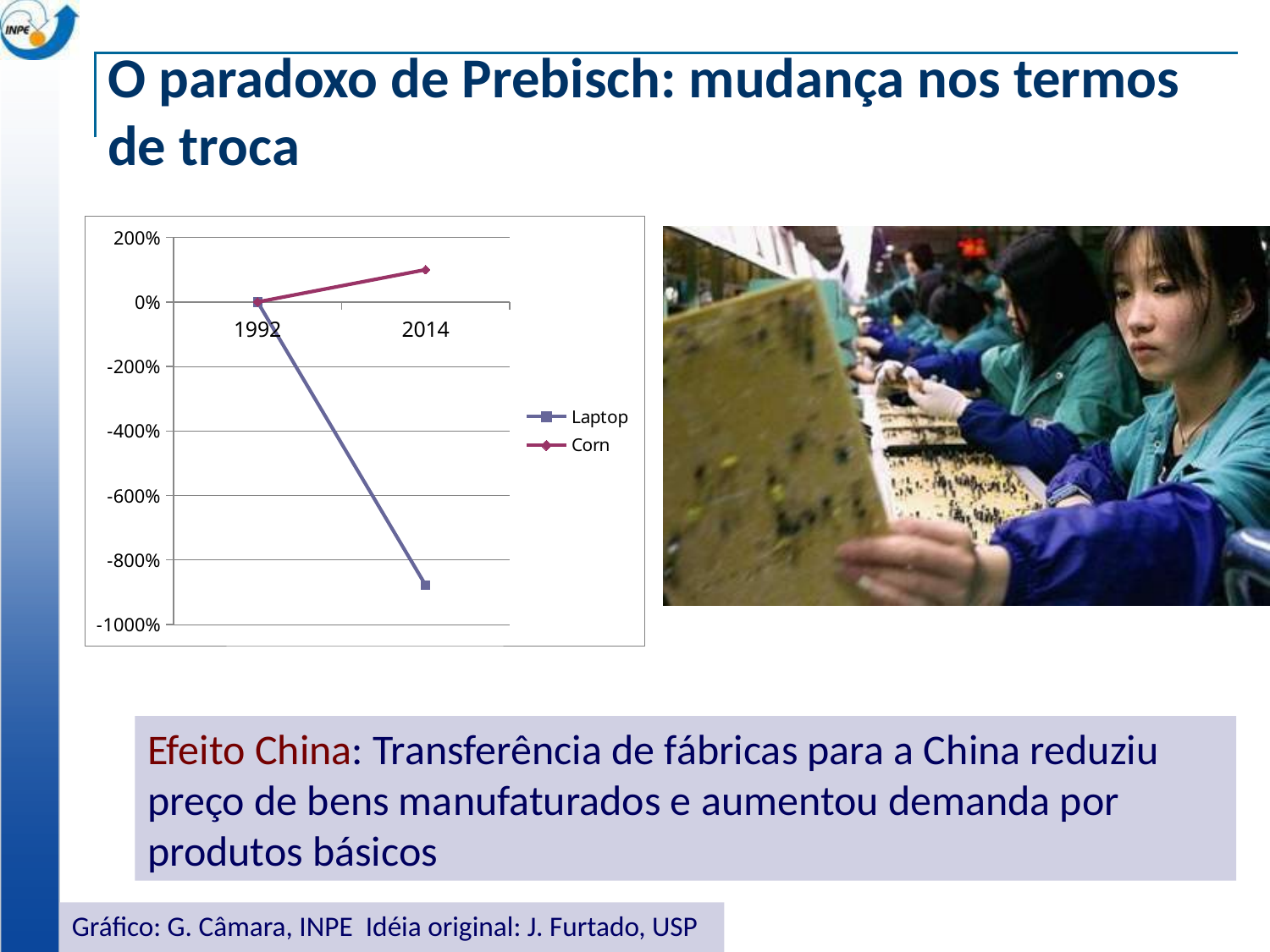
How many series does the chart's legend list? 2 Does the Laptop series rise or fall from 1992 to 2014? fall What kind of chart is shown on the slide? line chart In 2014, which series has the higher value, Laptop or Corn? Corn Which series is drawn with the purple-blue line marked with squares? Laptop Is the value for Corn in 2014 greater or less than 200%? less Does the Corn series rise or fall from 1992 to 2014? rise What is the value for Corn in 1992? 0% Is the value for Laptop in 2014 greater or less than -800%? less Is the value for Corn in 2014 greater or less than 0%? greater How many years are shown on the x axis of the chart? 2 What is the value for Laptop in 1992? 0%